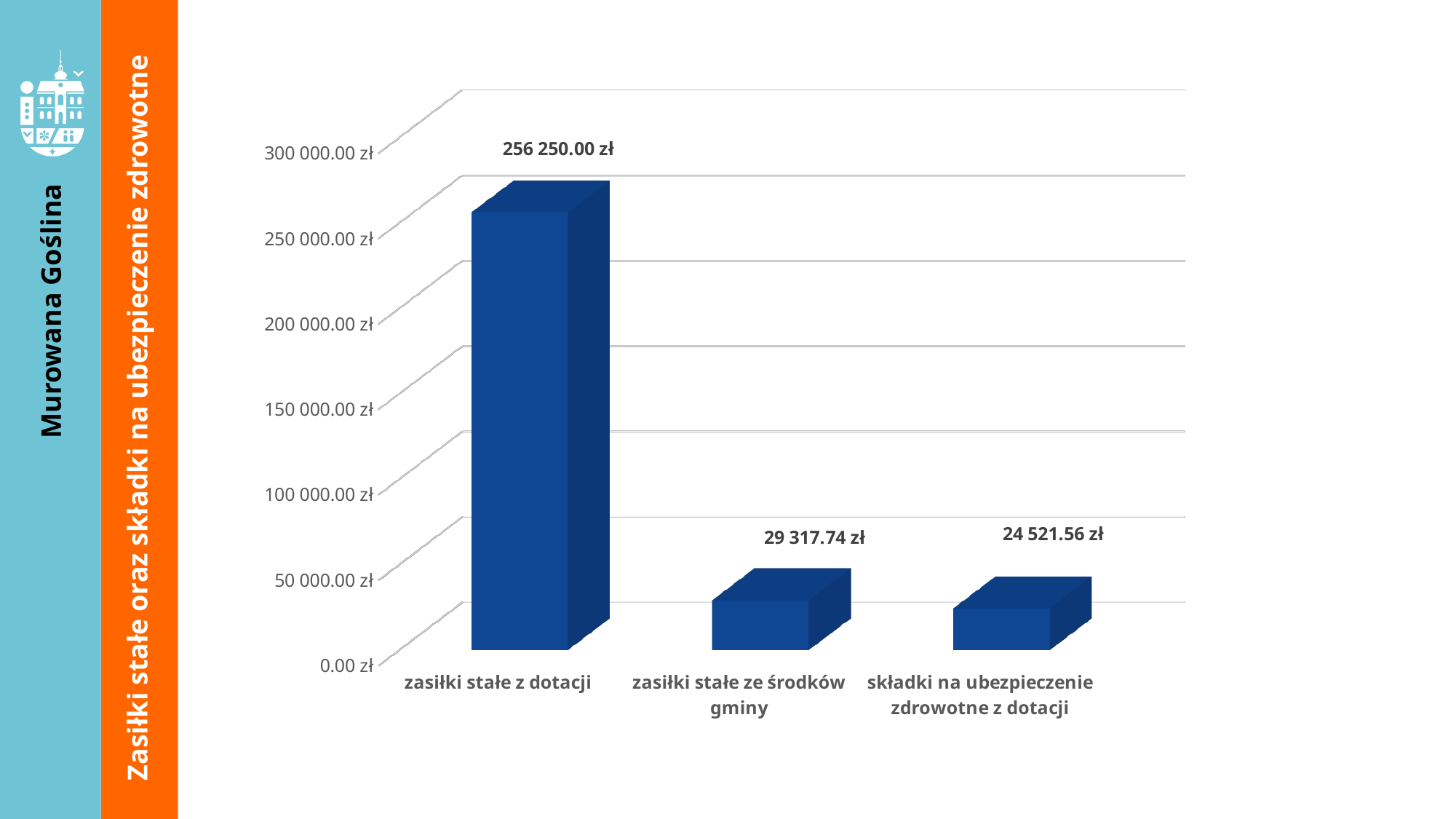
What is the difference between the values for "zasiłki stałe z dotacji" and "zasiłki stałe ze środków gminy"? 226 932.26 zł Which category has the lowest value? składki na ubezpieczenie zdrowotne z dotacji Is the value for "zasiłki stałe z dotacji" greater or less than 200 000.00 zł? greater What kind of chart is shown on the slide? bar chart Which category has the highest value? zasiłki stałe z dotacji What is the value for "zasiłki stałe z dotacji"? 256 250.00 zł What is the value for "zasiłki stałe ze środków gminy"? 29 317.74 zł How many categories are shown in the chart? 3 What is the value for "składki na ubezpieczenie zdrowotne z dotacji"? 24 521.56 zł Is the value for "składki na ubezpieczenie zdrowotne z dotacji" greater or less than 50 000.00 zł? less Which is larger: the value for "zasiłki stałe ze środków gminy" or for "składki na ubezpieczenie zdrowotne z dotacji"? zasiłki stałe ze środków gminy What is the difference between the values for "zasiłki stałe ze środków gminy" and "składki na ubezpieczenie zdrowotne z dotacji"? 4 796.18 zł